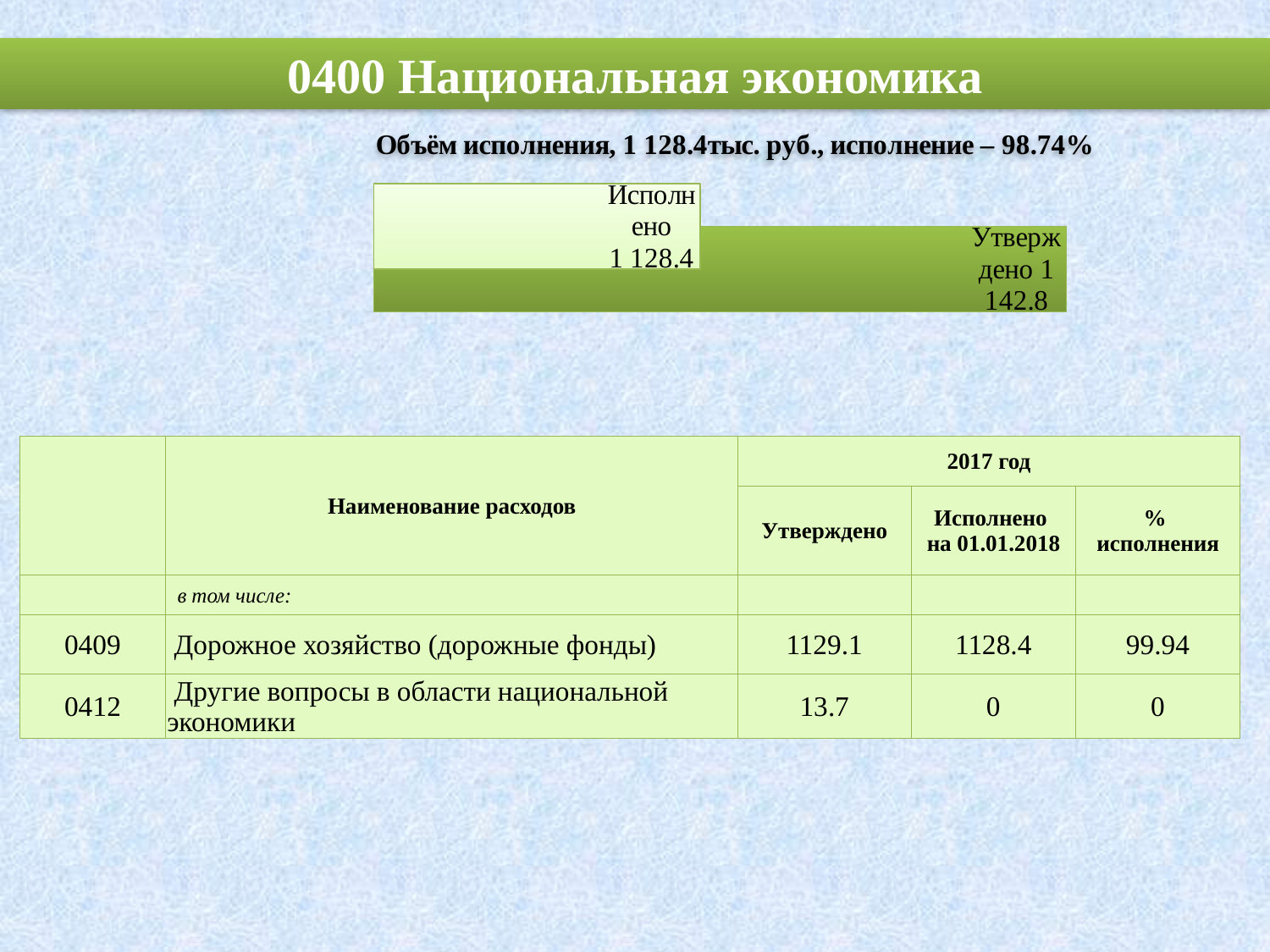
What is the difference between the Утверждено and Исполнено values in the bar chart? 14.4 Which bar in the chart is drawn in the darker green colour? Утверждено Is the value for Исполнено larger or smaller than the value for Утверждено in the chart? smaller How many bars are plotted in the chart? 2 Are the bars in the chart oriented horizontally or vertically? horizontally Which bar in the chart has the higher value, Исполнено or Утверждено? Утверждено Which bar in the chart has the lower value? Исполнено What value is shown for Исполнено in the bar chart? 1 128.4 What kind of chart is shown on the slide? bar chart What value is shown for Утверждено in the bar chart? 1 142.8